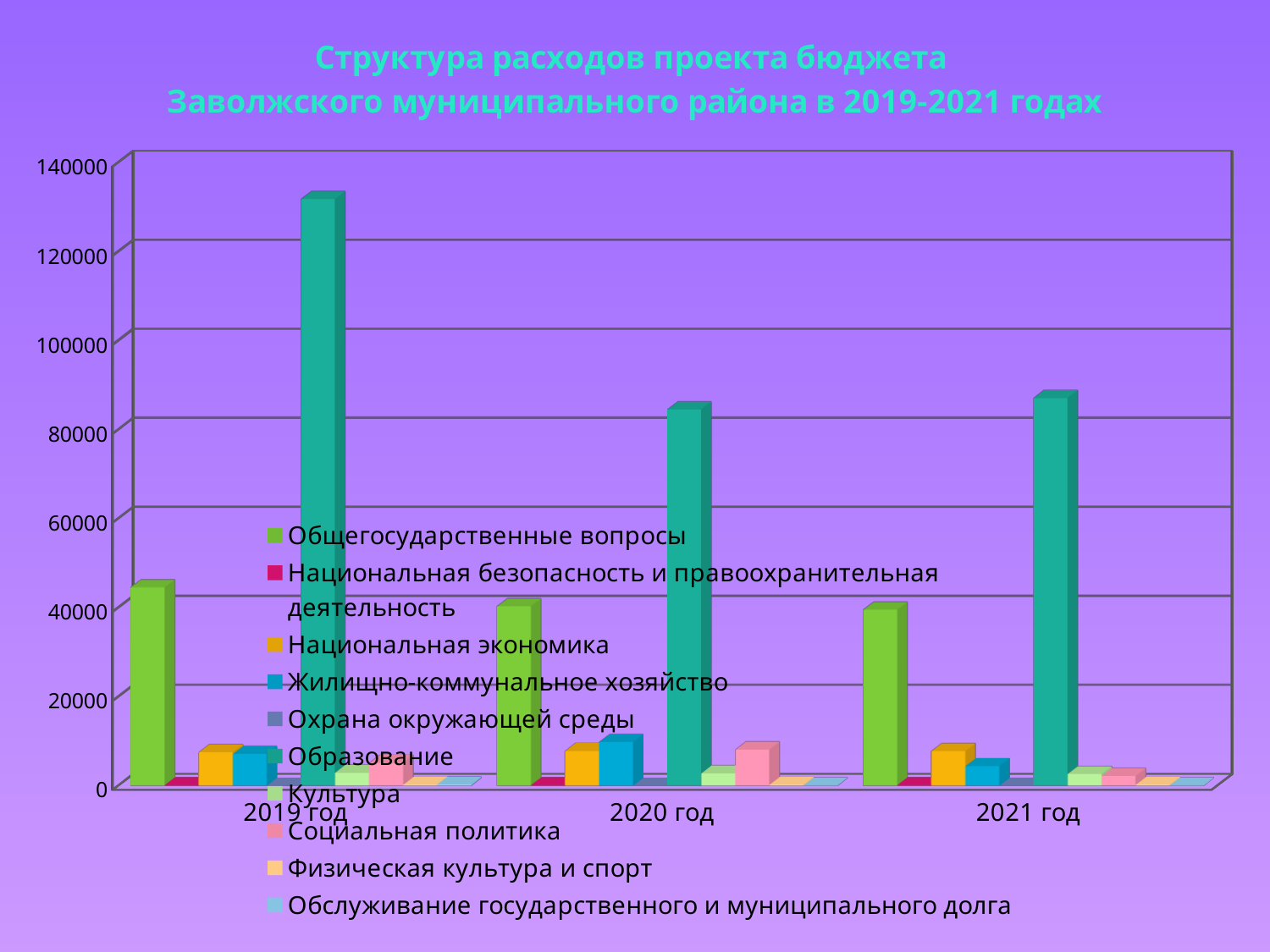
What is the title of the chart? Структура расходов проекта бюджета Заволжского муниципального района в 2019-2021 годах Which is larger in 2021 год: Общегосударственные вопросы or Национальная экономика? Общегосударственные вопросы What kind of chart is shown on the slide? bar chart How many series does the legend list? 10 How many year categories are shown on the x axis? 3 Which series has the highest value in 2019 год? Образование Which is larger: the value for Образование in 2019 год or in 2020 год? 2019 год Is the value for Образование in 2020 год greater or less than 100000? less Which series has the highest value in 2021 год? Образование Is the value for Образование in 2019 год greater or less than 120000? greater Is the value for Национальная экономика in 2020 год greater or less than 20000? less